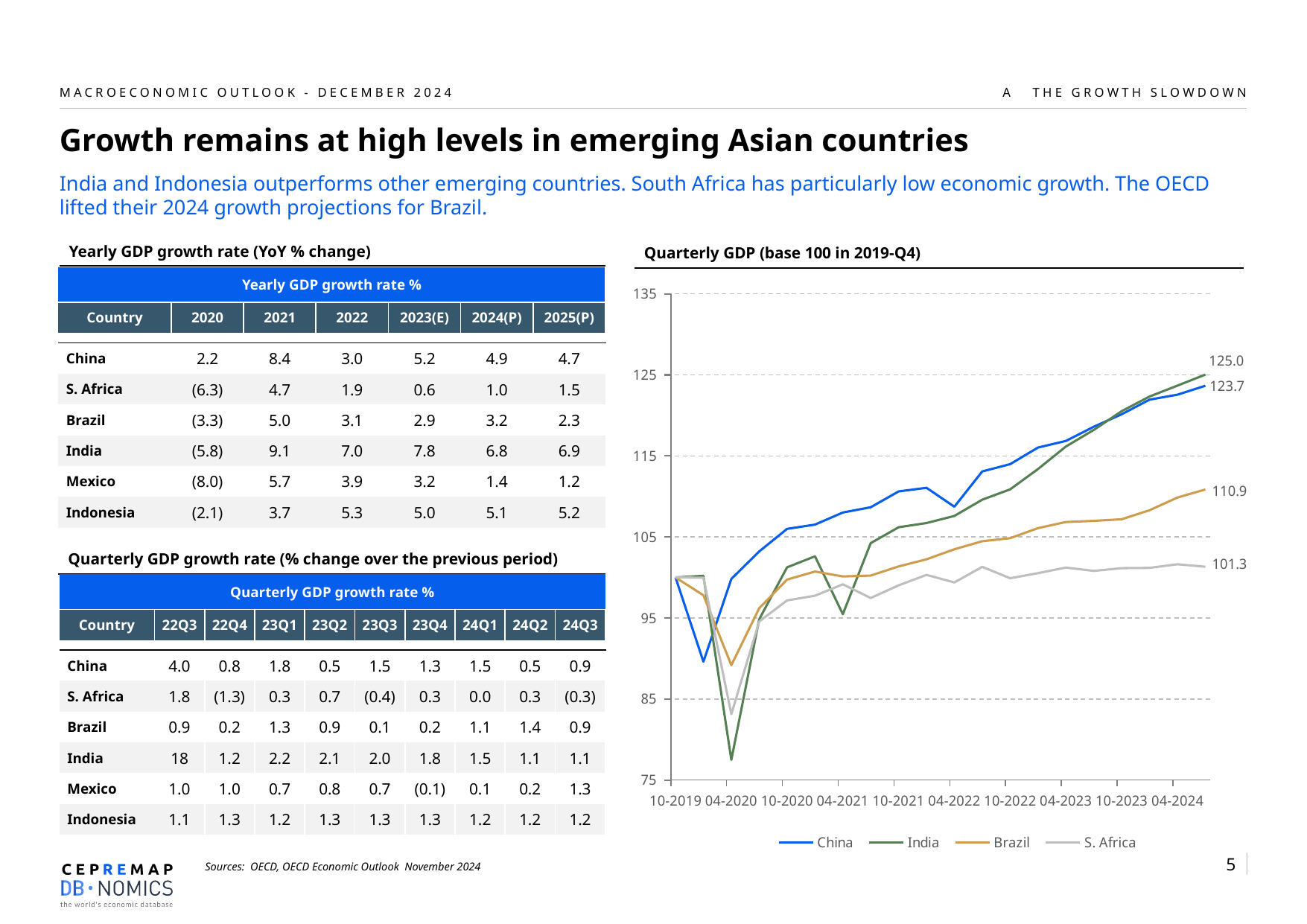
In the Quarterly GDP chart, which country has the highest value at the end of the series? India In the Quarterly GDP chart, what is the final labelled value for Brazil? 110.9 What kind of chart is the "Quarterly GDP (base 100 in 2019-Q4)" chart? line chart In the Quarterly GDP chart, is the final value for Brazil or for S. Africa larger? Brazil In the Quarterly GDP chart, which country has the lowest value at the end of the series? S. Africa In the Quarterly GDP chart, is the value for India at 04-2020 greater or less than 85? less In the Quarterly GDP chart, what is the final labelled value for S. Africa? 101.3 In the Quarterly GDP chart, what is the difference between the final values of India and Brazil? 14.1 In the Quarterly GDP chart, what is the final labelled value for China? 123.7 How many series does the legend of the Quarterly GDP chart list? 4 In the Quarterly GDP chart, does the China line rise or fall overall from 04-2020 to 04-2024? rise In the Quarterly GDP chart, what is the final labelled value for India? 125.0